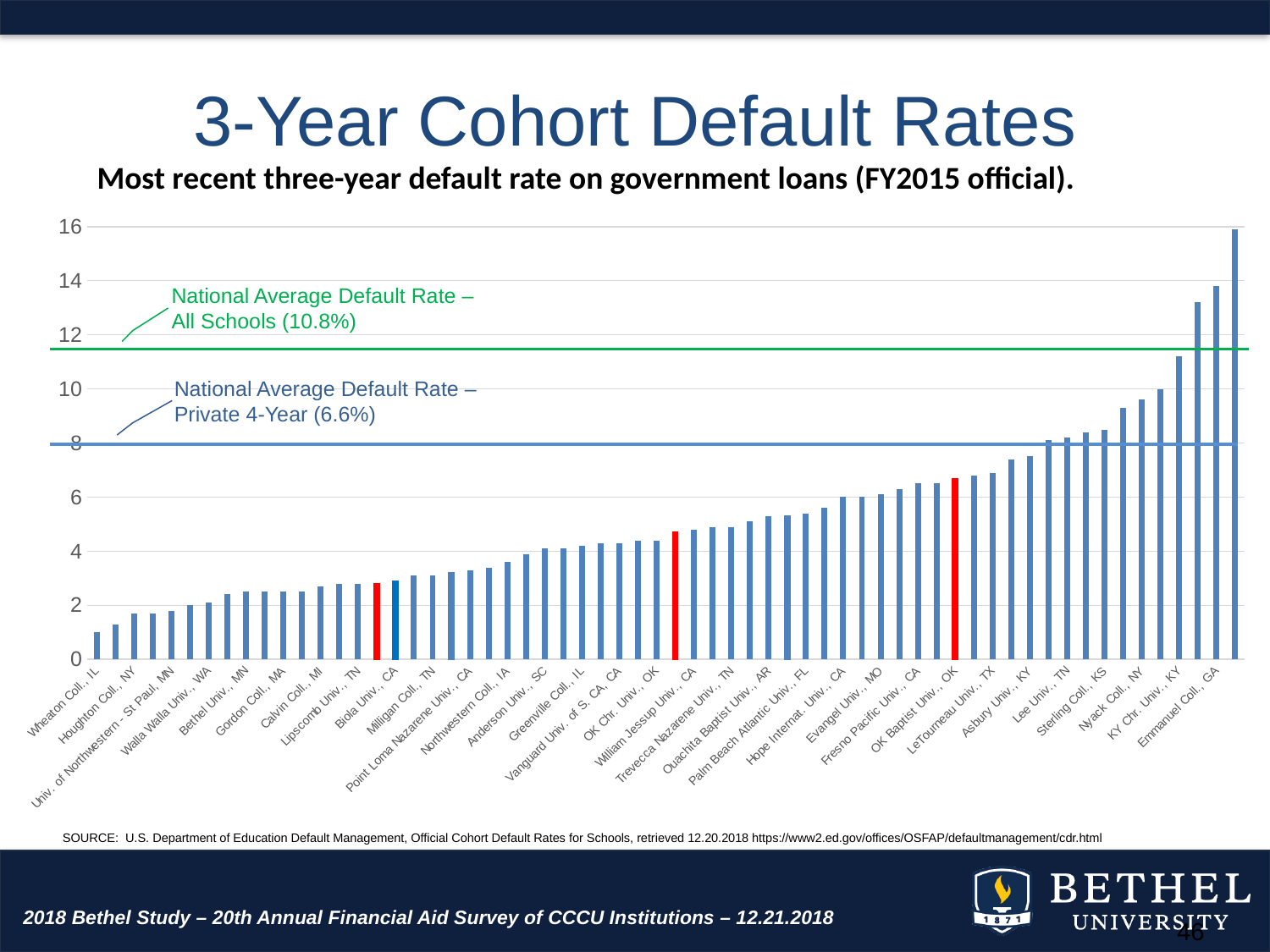
According to the annotation, what is the National Average Default Rate for Private 4-Year schools? 6.6% Is the value for Wheaton Coll., IL greater or less than 2? less Is the value for Nyack Coll., NY greater or less than 12? less What kind of chart is shown on the slide? bar chart According to the annotation, what is the National Average Default Rate for All Schools? 10.8% Which school has the lowest three-year default rate in the chart? Wheaton Coll., IL Which has the larger default rate, Nyack Coll., NY or Lee Univ., TN? Nyack Coll., NY Is the value for Trevecca Nazarene Univ., TN greater or less than 4? greater Do the default rates rise or fall moving from left to right along the x axis? rise